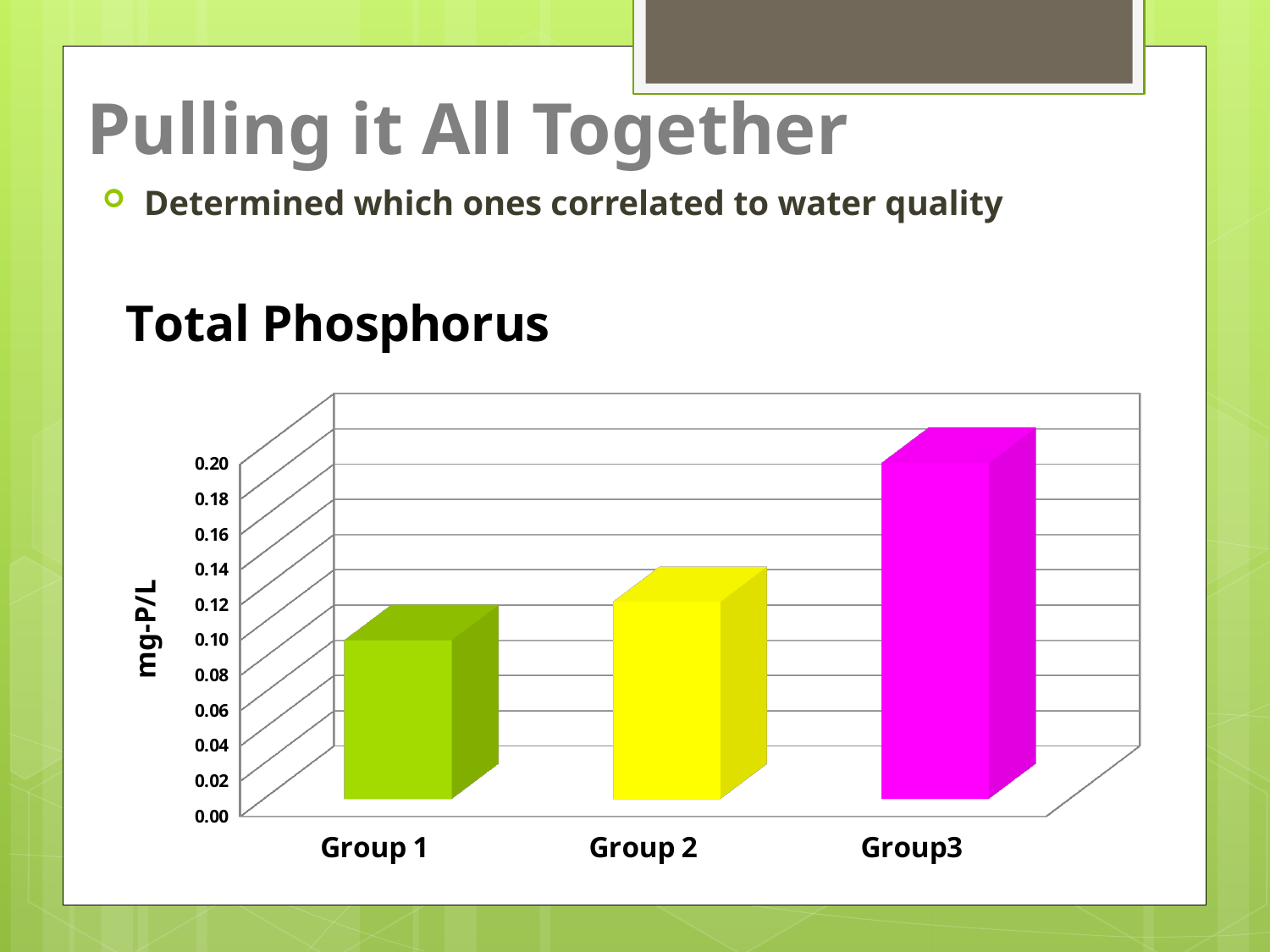
Which is larger, the value for Group3 or the value for Group 2? Group3 What kind of chart is shown on the slide? bar chart How many groups are plotted on the chart? 3 Is the value for Group 2 greater or less than 0.16? less What is the label on the vertical axis of the chart? mg-P/L Which group has the highest total phosphorus value? Group3 Is the value for Group 1 greater or less than 0.06? greater What is the title of the chart? Total Phosphorus Is the value for Group3 greater or less than 0.16? greater Do the values rise or fall from Group 1 to Group3? rise Which group has the lowest total phosphorus value? Group 1